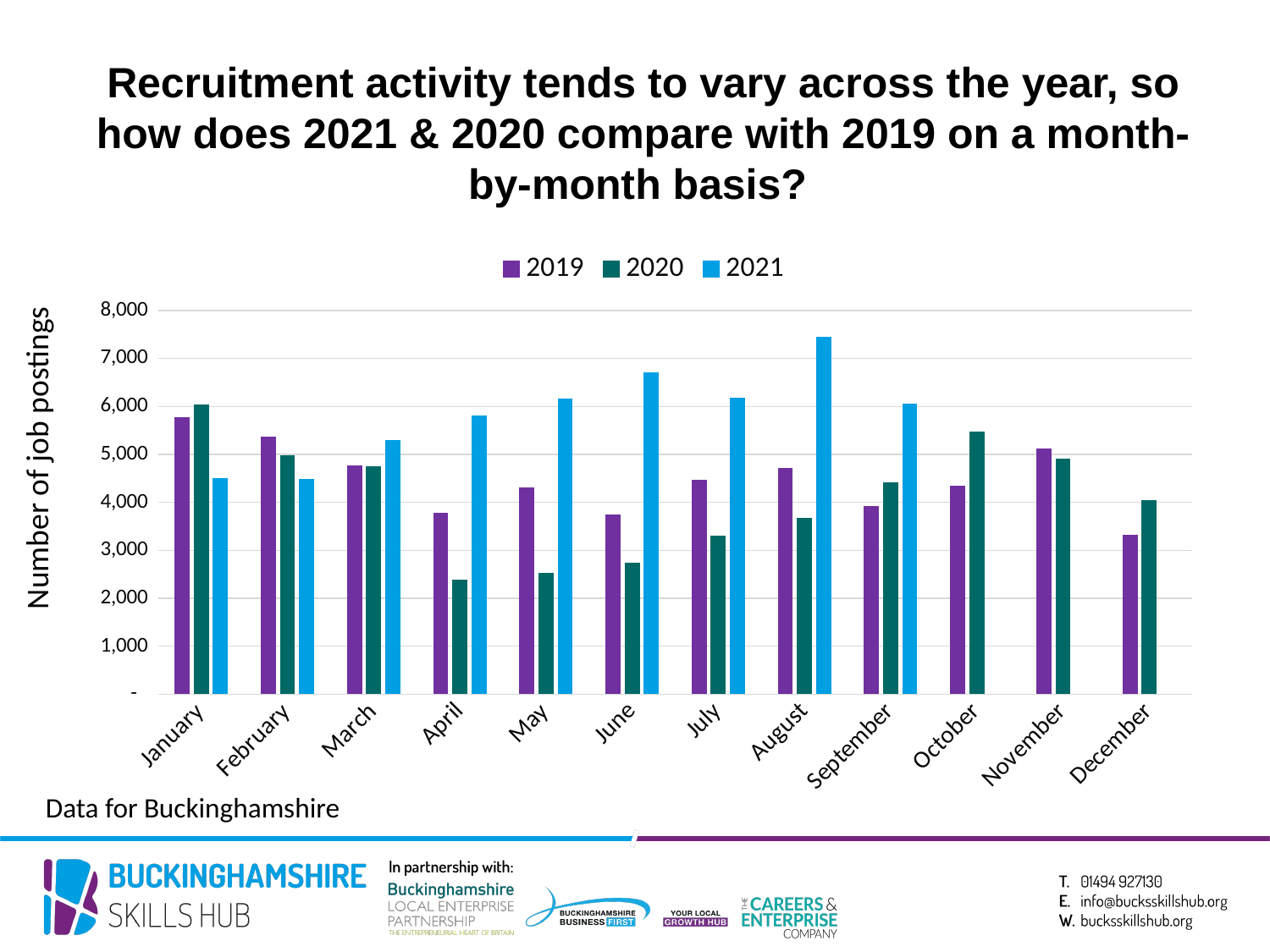
How many months are shown on the x axis? 12 For how many months is a 2021 bar plotted? 9 How many series does the legend list? 3 What is the title of the y axis? Number of job postings In which month is the 2019 value lowest? December In which month is the 2021 value highest? August Is the 2021 value for August greater or less than 7,000? greater In April, which year has the larger value, 2019 or 2021? 2021 Do the 2020 values rise or fall from January to April? fall What type of chart is shown on the slide? Bar chart Is the 2020 value for April greater or less than 3,000? less In October, which year has the larger value, 2019 or 2020? 2020